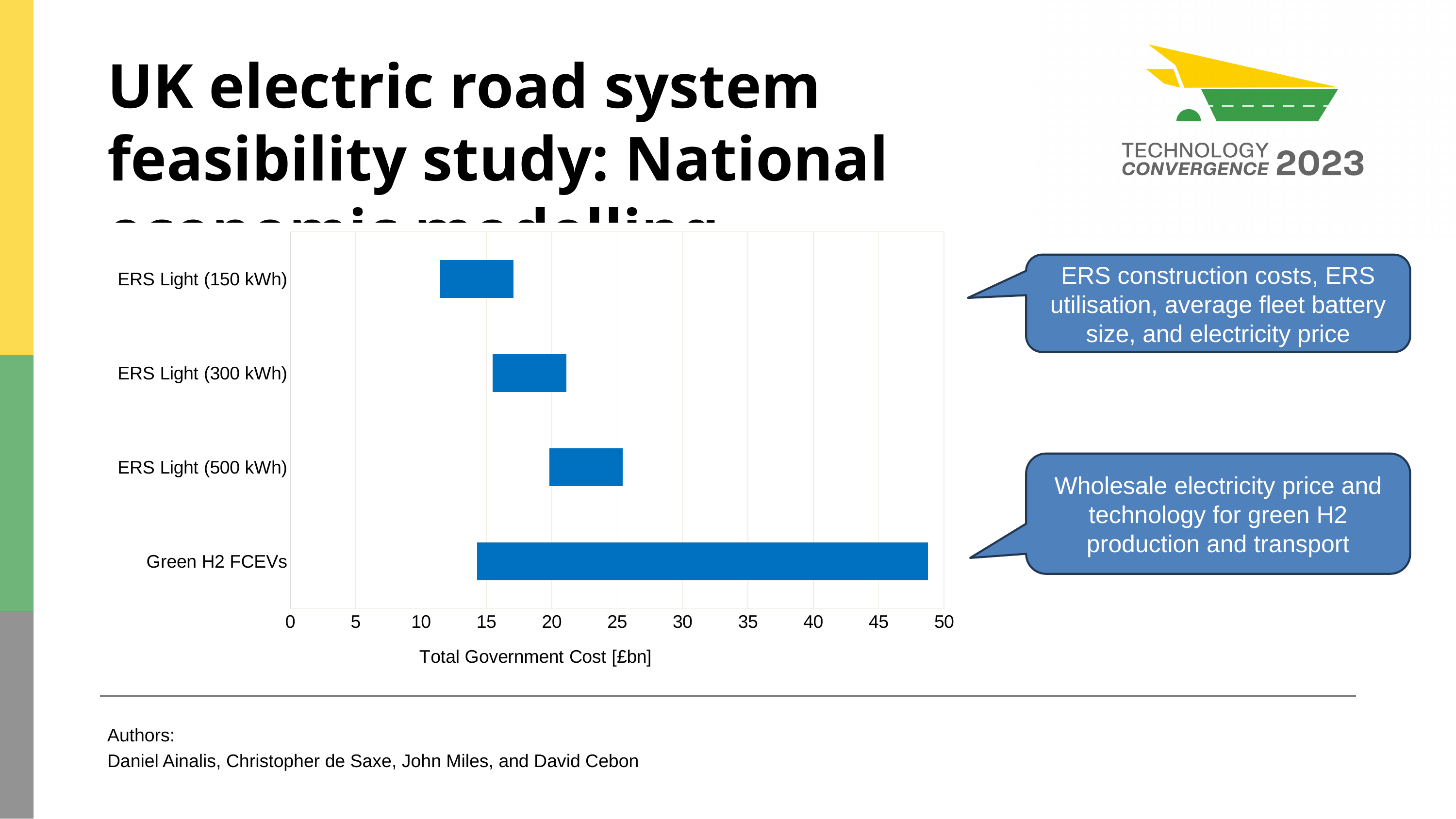
Is the upper end of the ERS Light (150 kWh) bar greater or less than 20? less Which bar extends further to the right, ERS Light (500 kWh) or ERS Light (150 kWh)? ERS Light (500 kWh) Which category's bar extends furthest to the right on the chart? Green H2 FCEVs Which category's bar starts furthest to the left on the chart? ERS Light (150 kWh) Is the upper end of the Green H2 FCEVs bar greater or less than 45? greater Which category has the widest range of Total Government Cost on the chart? Green H2 FCEVs What colour are the bars on the chart? blue What is the title of the horizontal axis of the chart? Total Government Cost [£bn] How many categories are plotted on the chart? 4 Is the upper end of the ERS Light (300 kWh) bar greater or less than 25? less What kind of chart is shown on the slide? bar chart